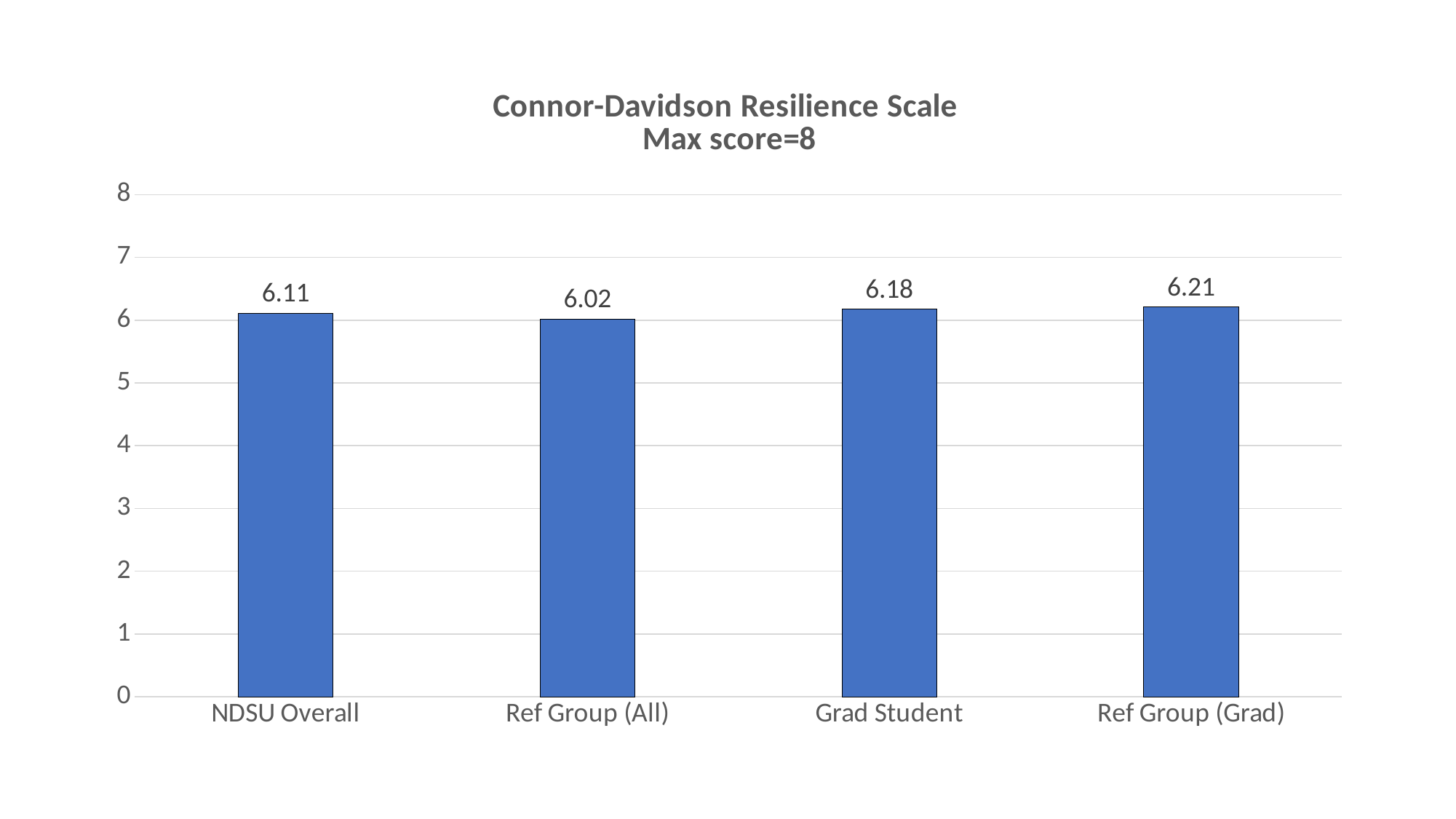
Which category has the lowest value? Ref Group (All) What is the value for Ref Group (Grad)? 6.21 Which is larger, the value for Grad Student or the value for NDSU Overall? Grad Student What is the value for NDSU Overall? 6.11 What is the value for Grad Student? 6.18 What kind of chart is this? Bar chart Which category has the highest value? Ref Group (Grad) What is the title of the chart? Connor-Davidson Resilience Scale Max score=8 How many categories are shown on the x axis? 4 What is the difference between the values for Grad Student and NDSU Overall? 0.07 What is the value for Ref Group (All)? 6.02 What is the difference between the values for Ref Group (Grad) and Ref Group (All)? 0.19